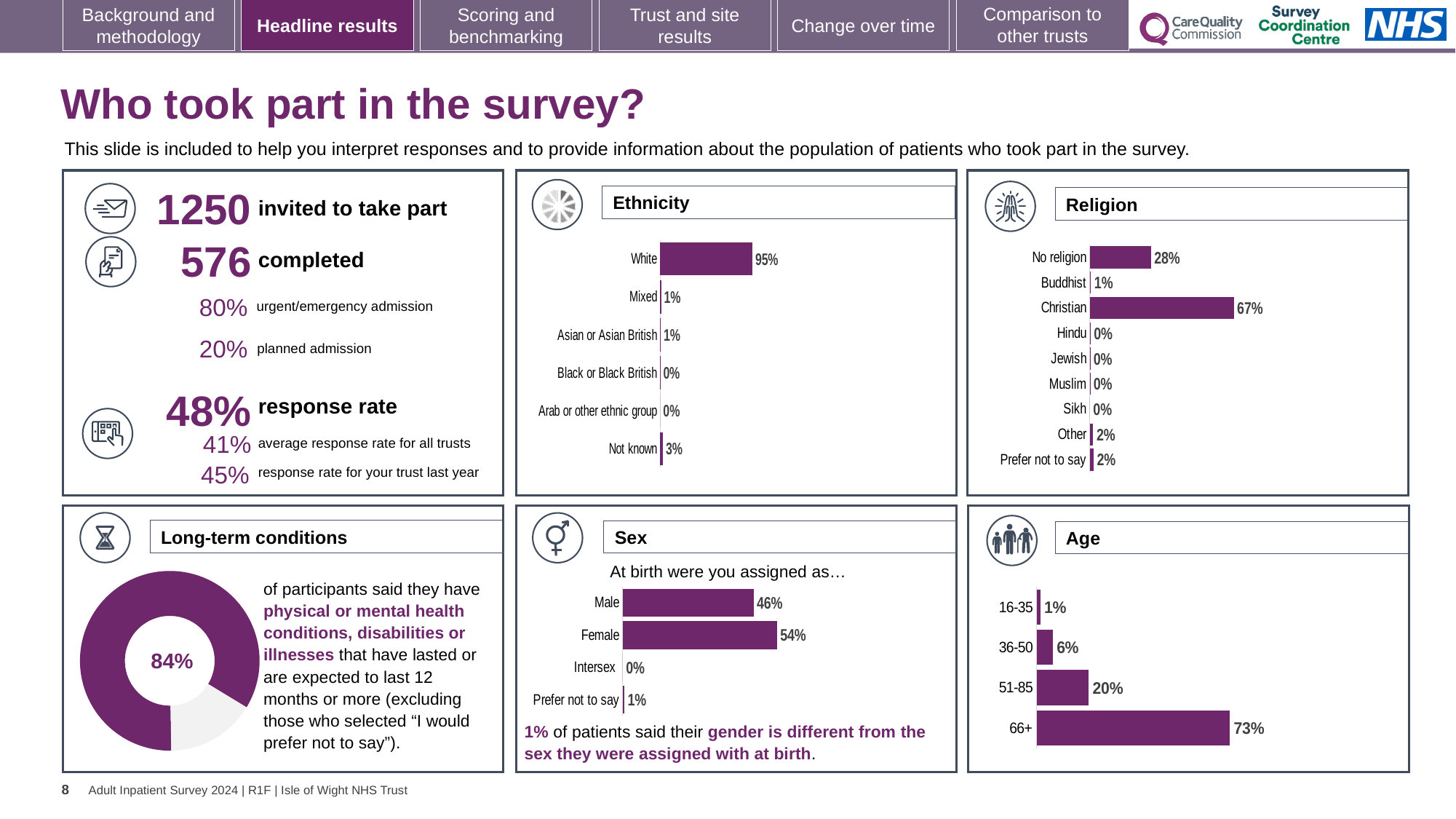
In the Religion chart, how many categories are shown? 9 In the Ethnicity chart, what percentage of respondents were White? 95% In the Ethnicity chart, which category has the highest value? White In the Religion chart, what percentage of respondents were Christian? 67% In the Religion chart, what is the difference between the Christian and No religion values? 39% In the Sex chart, which is larger, Male or Female? Female In the Sex chart, what percentage of respondents were Female? 54% In the Ethnicity chart, how many categories are shown? 6 In the Age chart, which age group has the lowest value? 16-35 What kind of chart is used in the Long-term conditions panel? doughnut chart In the Age chart, do the values rise or fall as the age groups get older? rise In the Age chart, what percentage of respondents were aged 66+? 73%